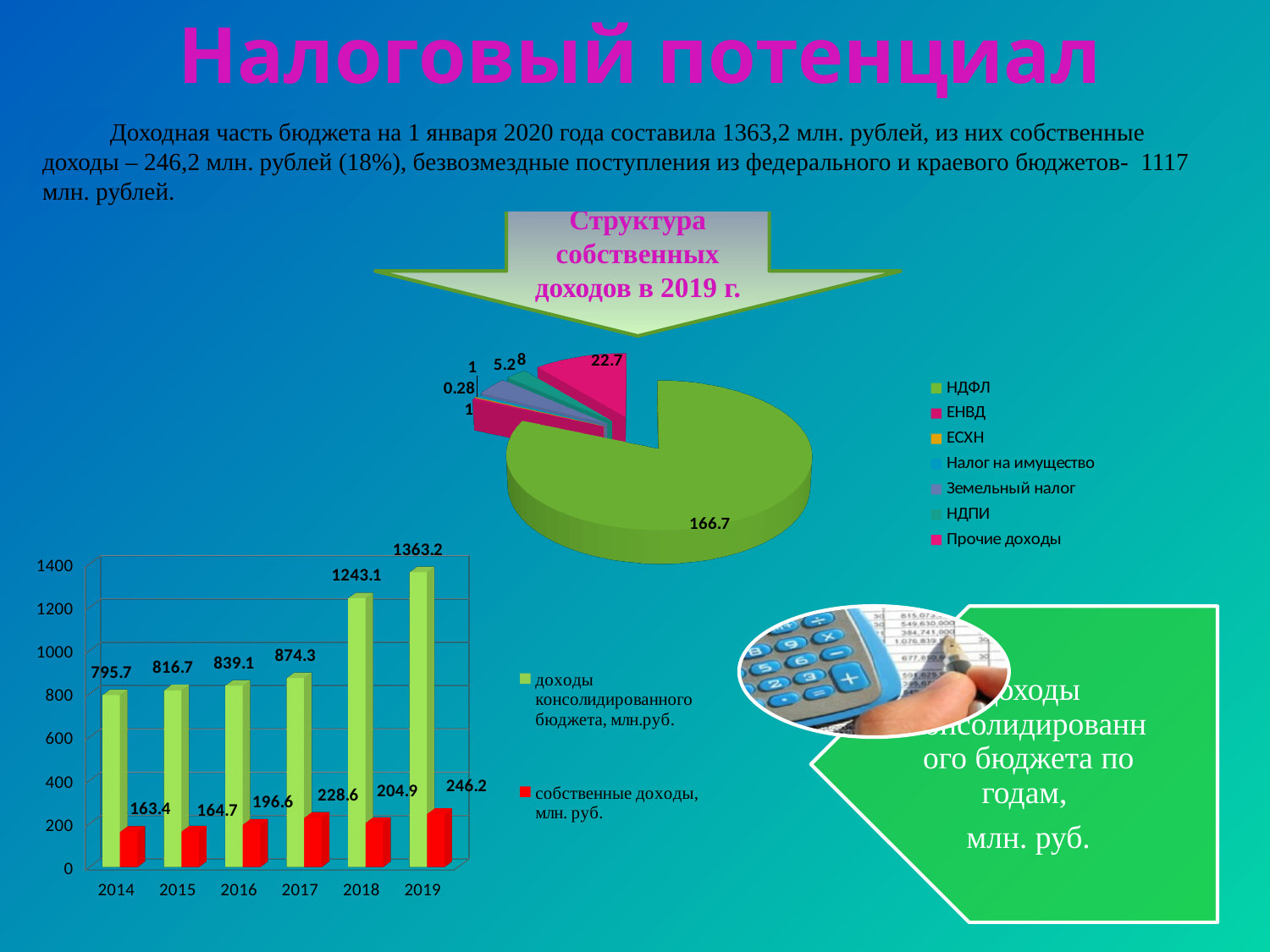
In the pie chart 'Структура собственных доходов в 2019 г.', how many categories does the legend list? 7 In the pie chart 'Структура собственных доходов в 2019 г.', which category has the largest slice? НДФЛ In the bar chart at the bottom left, how many years are shown on the x axis? 6 In the bar chart at the bottom left, do the values of доходы консолидированного бюджета rise or fall from 2014 to 2019? rise In the pie chart 'Структура собственных доходов в 2019 г.', what is the value of the НДФЛ slice? 166.7 In the bar chart at the bottom left, what is the value of собственные доходы for 2017? 228.6 In the bar chart at the bottom left, how many series does the legend list? 2 In the bar chart at the bottom left, which year has the lowest value of собственные доходы? 2014 In the bar chart at the bottom left, what is the value of доходы консолидированного бюджета for 2019? 1363.2 In the bar chart at the bottom left, what is the difference between доходы консолидированного бюджета in 2019 and in 2018? 120.1 In the bar chart at the bottom left, which year has the highest value of доходы консолидированного бюджета? 2019 In the bar chart at the bottom left, is the value of собственные доходы larger in 2017 or in 2018? 2017